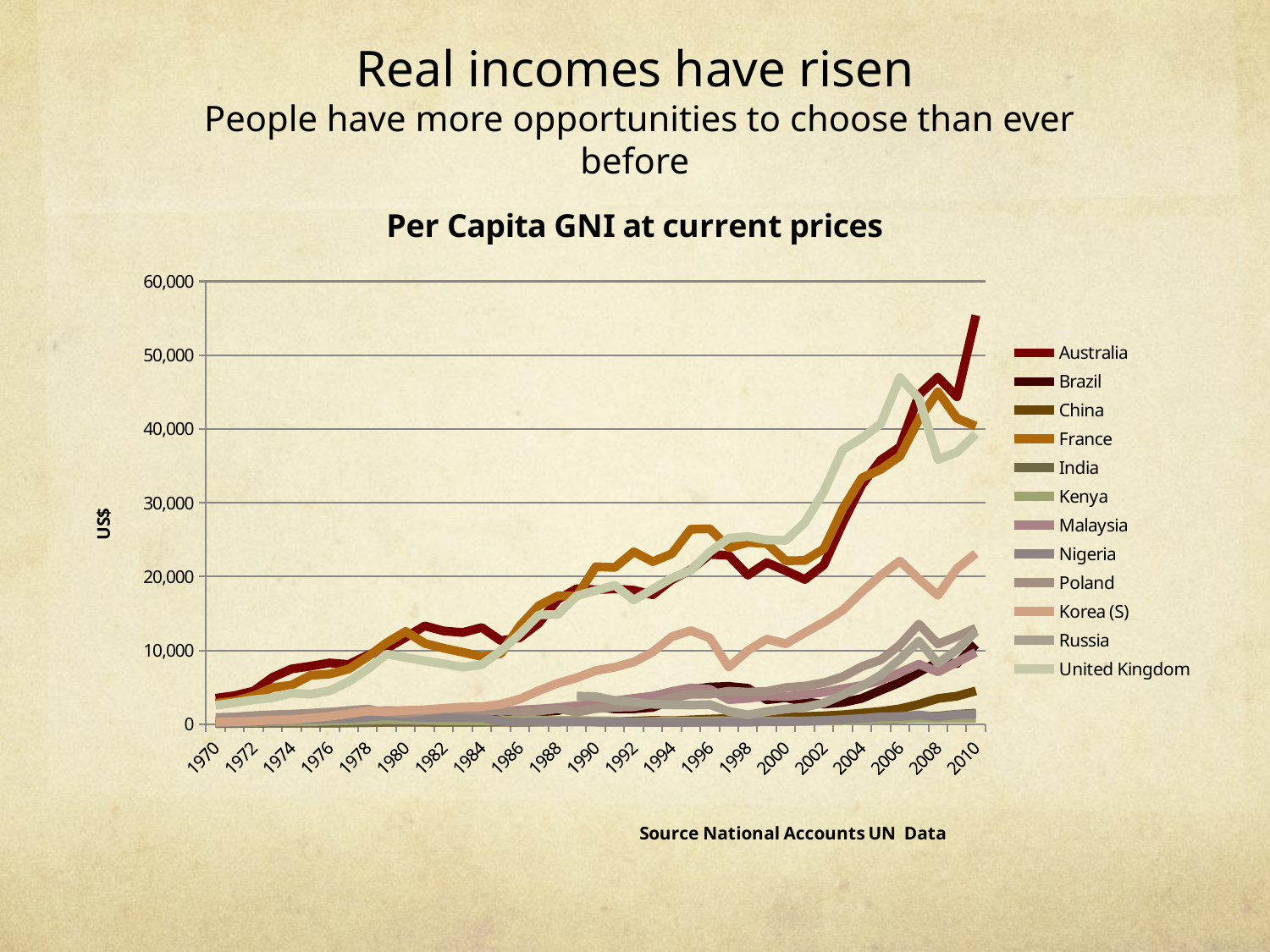
How many series does the legend list? 12 Is the value for the United Kingdom in 2006 greater or less than 40,000? greater What is the label on the vertical axis? US$ Is the value for Australia in 2010 greater or less than 50,000? greater Is the value for China in 2010 greater or less than 10,000? less Does the value for Korea (S) generally rise or fall from 1970 to 2010? rise Which country has the highest per capita GNI in 2006? United Kingdom What is the title of the chart? Per Capita GNI at current prices Which country has the highest per capita GNI in 2010? Australia In 2010, which is larger, the value for Australia or the value for Korea (S)? Australia What kind of chart is shown on the slide? line chart